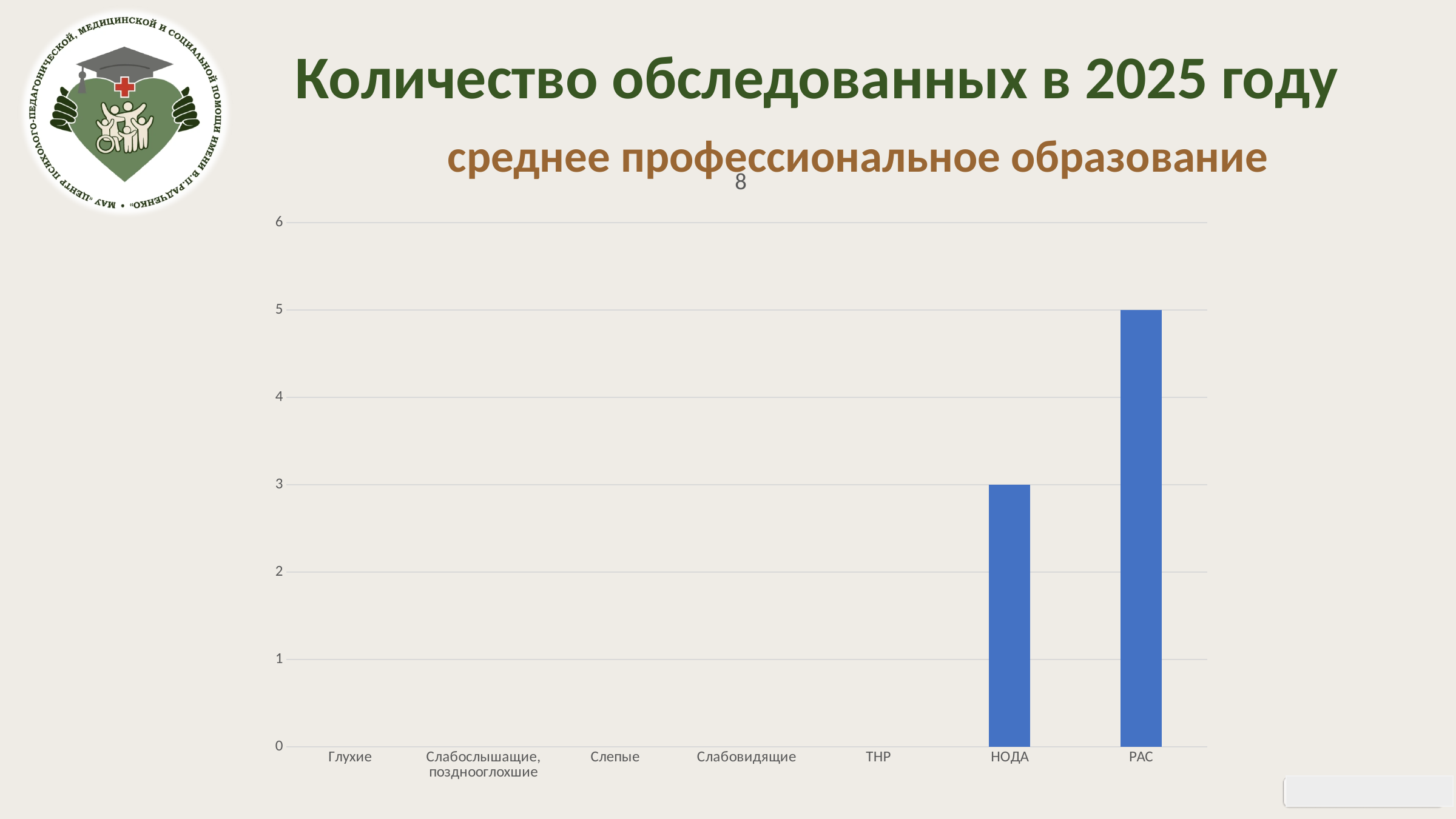
Which category has the highest value? РАС How many categories are shown on the x axis? 7 What is the value for РАС? 5 Which is larger, the value for НОДА or the value for РАС? РАС Is the value for НОДА greater or less than 2? greater How many categories have a visible bar? 2 What kind of chart is shown on the slide? bar chart What is the highest value labelled on the vertical axis? 6 What is the difference between the values for РАС and НОДА? 2 What is the value for НОДА? 3 What is the subtitle shown above the chart? среднее профессиональное образование Is the value for РАС greater or less than 4? greater